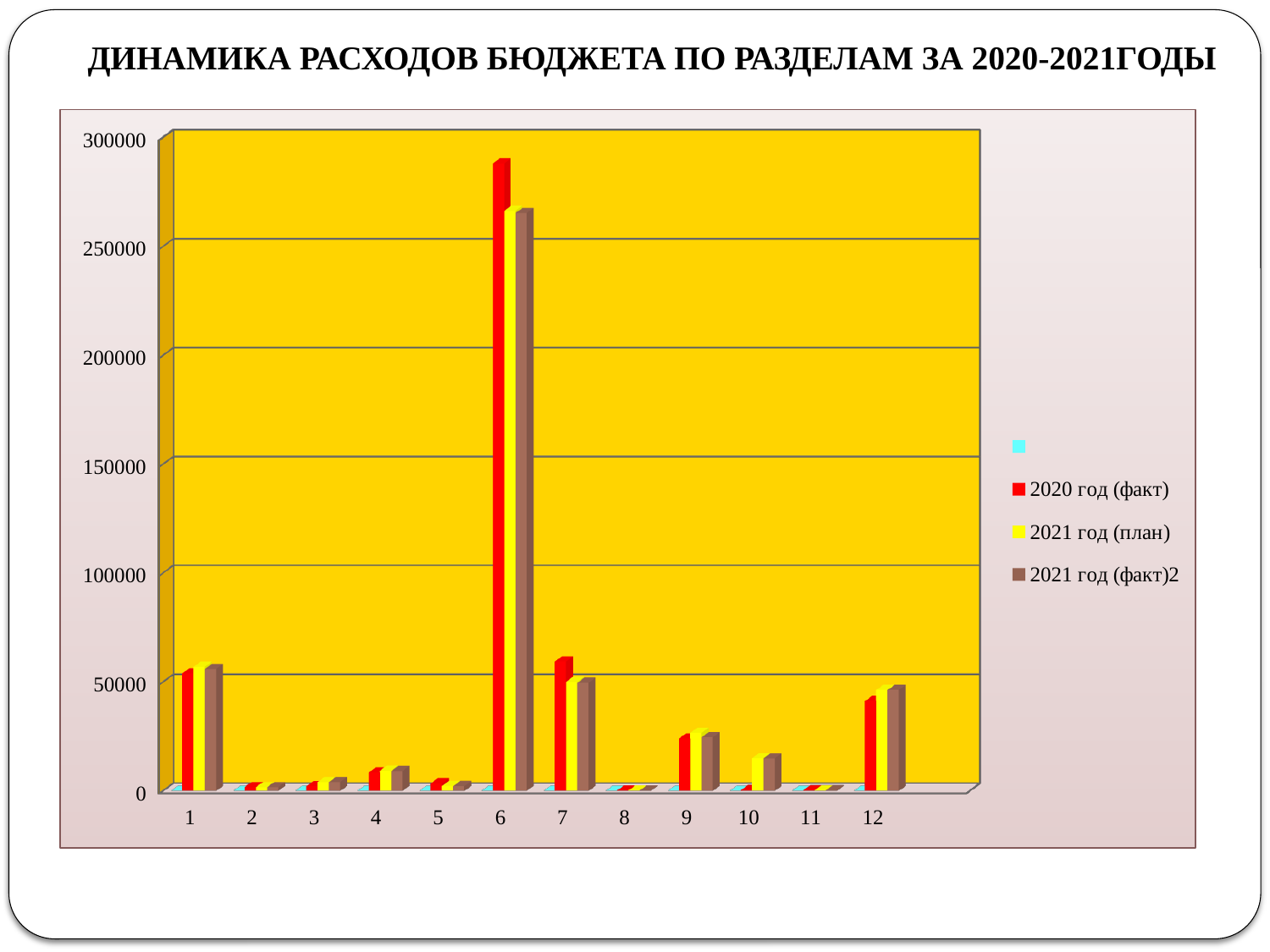
Is the value for category 12 in the 2020 год (факт) series greater or less than 50000? less How many named series does the legend list? 3 Is the value for category 7 in the 2020 год (факт) series greater or less than 50000? greater Which category has the highest value for the 2020 год (факт) series? 6 Is the value for category 9 in the 2021 год (факт)2 series greater or less than 50000? less How many categories are shown on the x axis? 12 What is the title of the chart? ДИНАМИКА РАСХОДОВ БЮДЖЕТА ПО РАЗДЕЛАМ ЗА 2020-2021ГОДЫ In the 2021 год (план) series, which is larger: category 12 or category 10? category 12 In the 2020 год (факт) series, which is larger: category 6 or category 7? category 6 What kind of chart is shown on the slide? bar chart